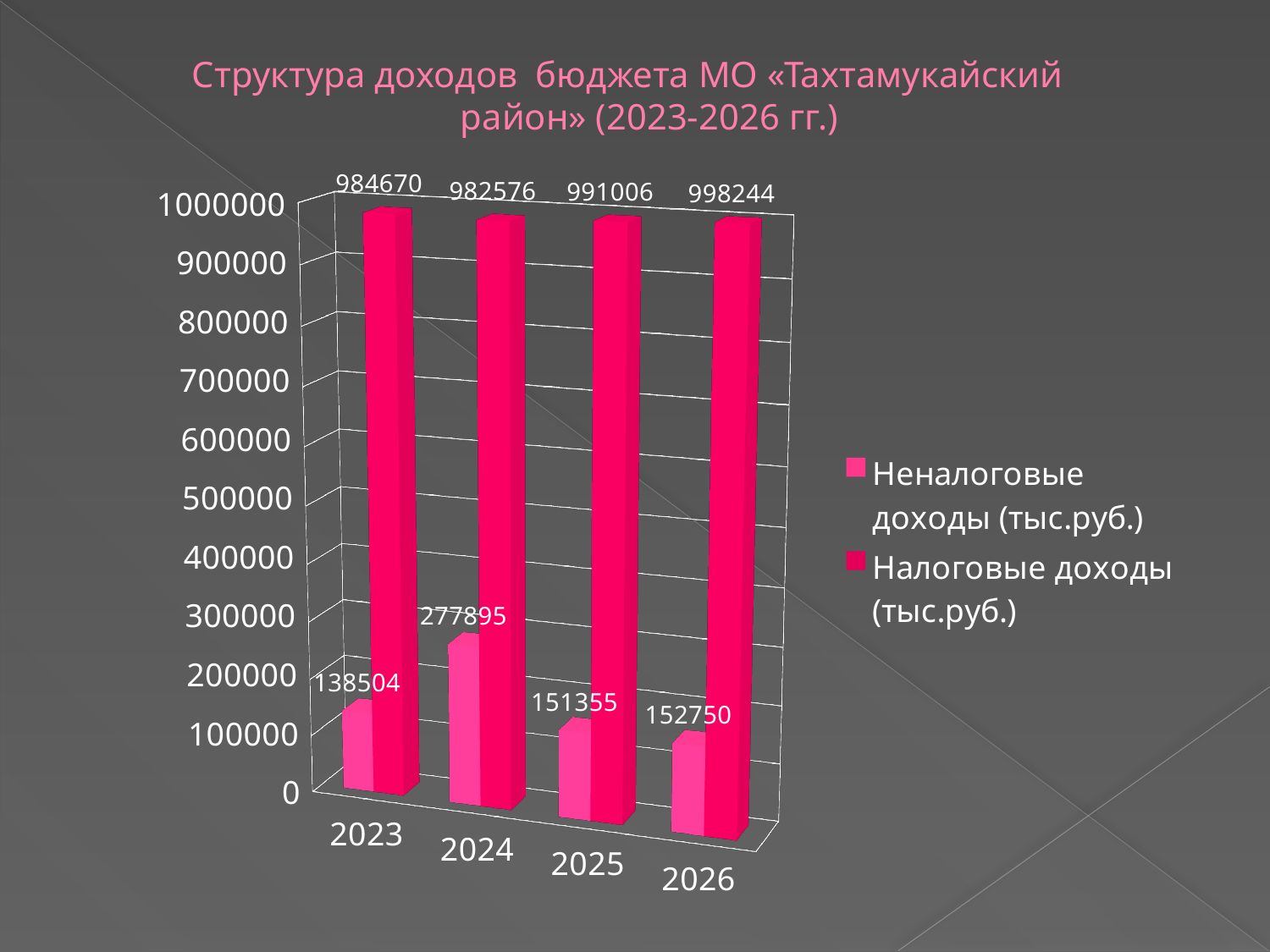
How many series does the legend list? 2 What is the value of Неналоговые доходы (тыс.руб.) for 2024? 277895 What is the value of Неналоговые доходы (тыс.руб.) for 2026? 152750 Which is larger: Неналоговые доходы (тыс.руб.) in 2025 or in 2026? 2026 What is the value of Налоговые доходы (тыс.руб.) for 2025? 991006 In which year is Неналоговые доходы (тыс.руб.) lowest? 2023 How many years are shown on the x axis? 4 What kind of chart is shown on the slide? Bar chart What is the value of Налоговые доходы (тыс.руб.) for 2023? 984670 In which year is Налоговые доходы (тыс.руб.) highest? 2026 What is the difference between Неналоговые доходы (тыс.руб.) in 2024 and in 2023? 139391 In which year is Неналоговые доходы (тыс.руб.) highest? 2024